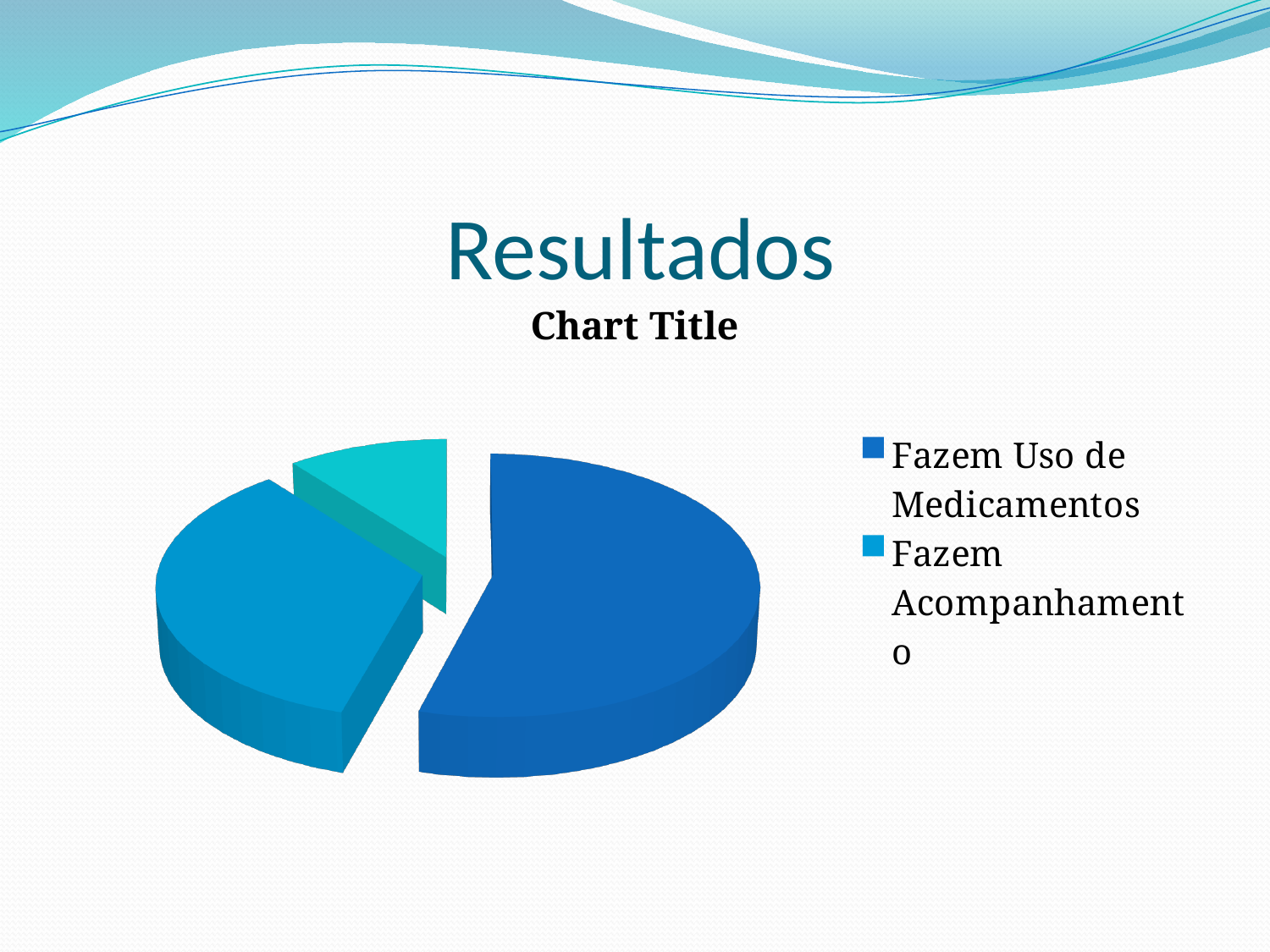
How many slices does the pie chart have? 3 Is the slice for Fazem Uso de Medicamentos greater or less than half of the pie? greater Which slice is larger: Fazem Uso de Medicamentos or Fazem Acompanhamento? Fazem Uso de Medicamentos How many entries does the chart legend list? 2 What is the title shown above the pie chart? Chart Title What kind of chart is shown on the slide? Pie chart Which legend category has the largest slice of the pie? Fazem Uso de Medicamentos What colour is the slice for Fazem Uso de Medicamentos? Dark blue